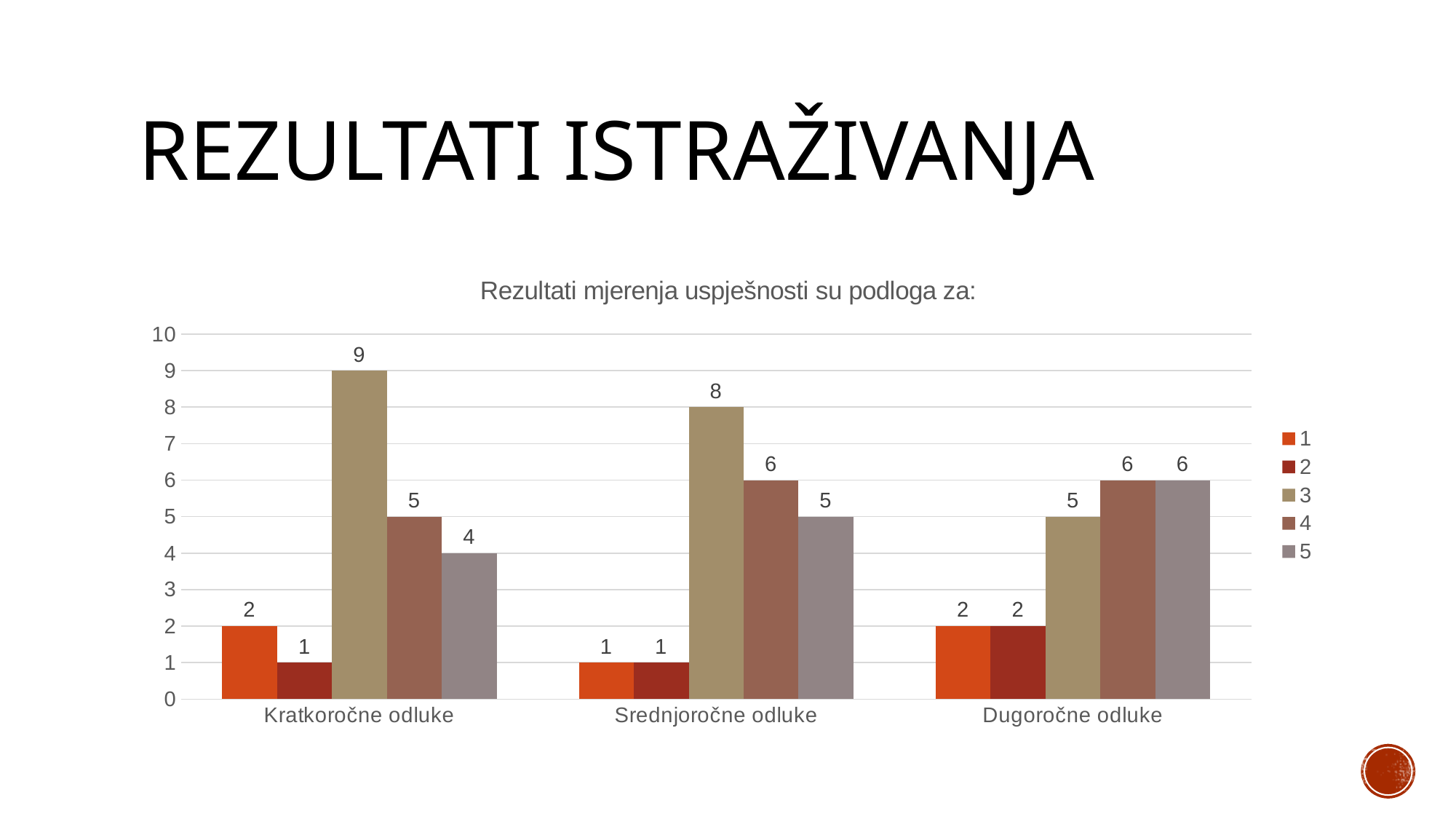
How many categories are shown on the x axis? 3 What is the value for series 1 in the Dugoročne odluke category? 2 Which is larger: series 3 in Kratkoročne odluke or series 3 in Dugoročne odluke? Kratkoročne odluke What is the value for series 5 in the Srednjoročne odluke category? 5 What is the difference between series 3 and series 4 in the Kratkoročne odluke category? 4 What is the title of the chart? Rezultati mjerenja uspješnosti su podloga za: Which series has the highest value in the Srednjoročne odluke category? 3 How many series does the legend list? 5 Does the value for series 3 rise or fall across the categories from Kratkoročne odluke to Dugoročne odluke? Fall What is the value for series 3 in the Kratkoročne odluke category? 9 Which series has the lowest value in the Kratkoročne odluke category? 2 What kind of chart is shown on the slide? Bar chart